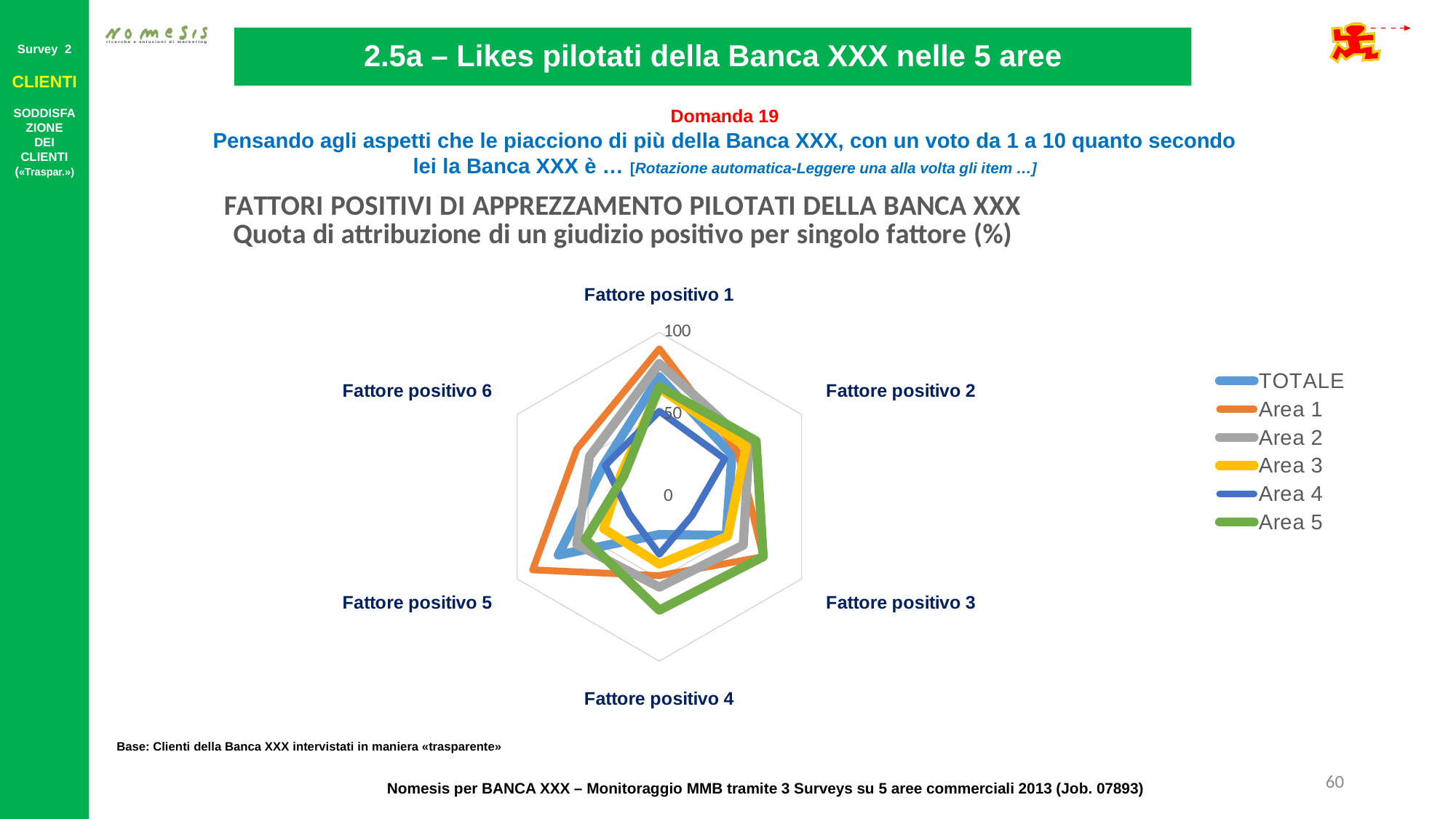
How many series does the legend list? 6 What kind of chart is shown on the slide? radar chart Which series are listed in the legend? TOTALE, Area 1, Area 2, Area 3, Area 4, Area 5 Is the value of Area 2 for Fattore positivo 1 greater or less than 50? greater How many categories (fattori positivi) does the radar chart have? 6 For Fattore positivo 5, which is larger: Area 1 or Area 4? Area 1 Is the value of Area 5 for Fattore positivo 4 greater or less than 50? greater Is the value of Area 1 for Fattore positivo 1 greater or less than 50? greater What is the maximum value shown on the radar chart's axis? 100 For Fattore positivo 4, which is larger: Area 5 or Area 4? Area 5